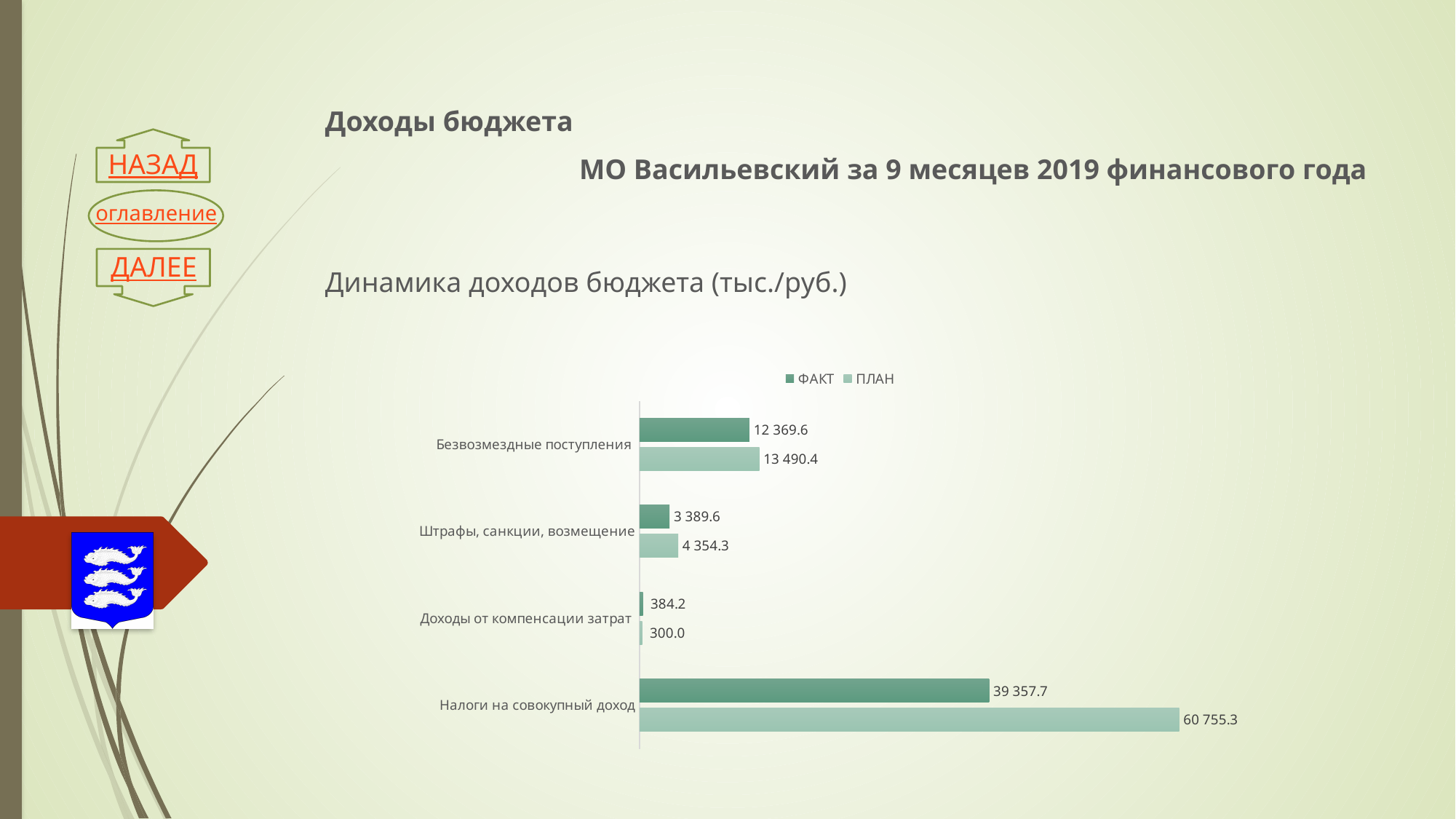
How many categories are shown in the chart? 4 What is the ФАКТ value for Налоги на совокупный доход? 39 357.7 What is the difference between the ПЛАН and ФАКТ values for Налоги на совокупный доход? 21 397.6 What type of chart is shown on the slide? Bar chart For Доходы от компенсации затрат, which is larger: ФАКТ or ПЛАН? ФАКТ What is the ФАКТ value for Штрафы, санкции, возмещение? 3 389.6 Which category has the highest ПЛАН value? Налоги на совокупный доход What is the difference between the ПЛАН and ФАКТ values for Штрафы, санкции, возмещение? 964.7 Which category has the lowest ФАКТ value? Доходы от компенсации затрат What is the ПЛАН value for Доходы от компенсации затрат? 300.0 What is the ПЛАН value for Безвозмездные поступления? 13 490.4 How many series does the legend list? 2